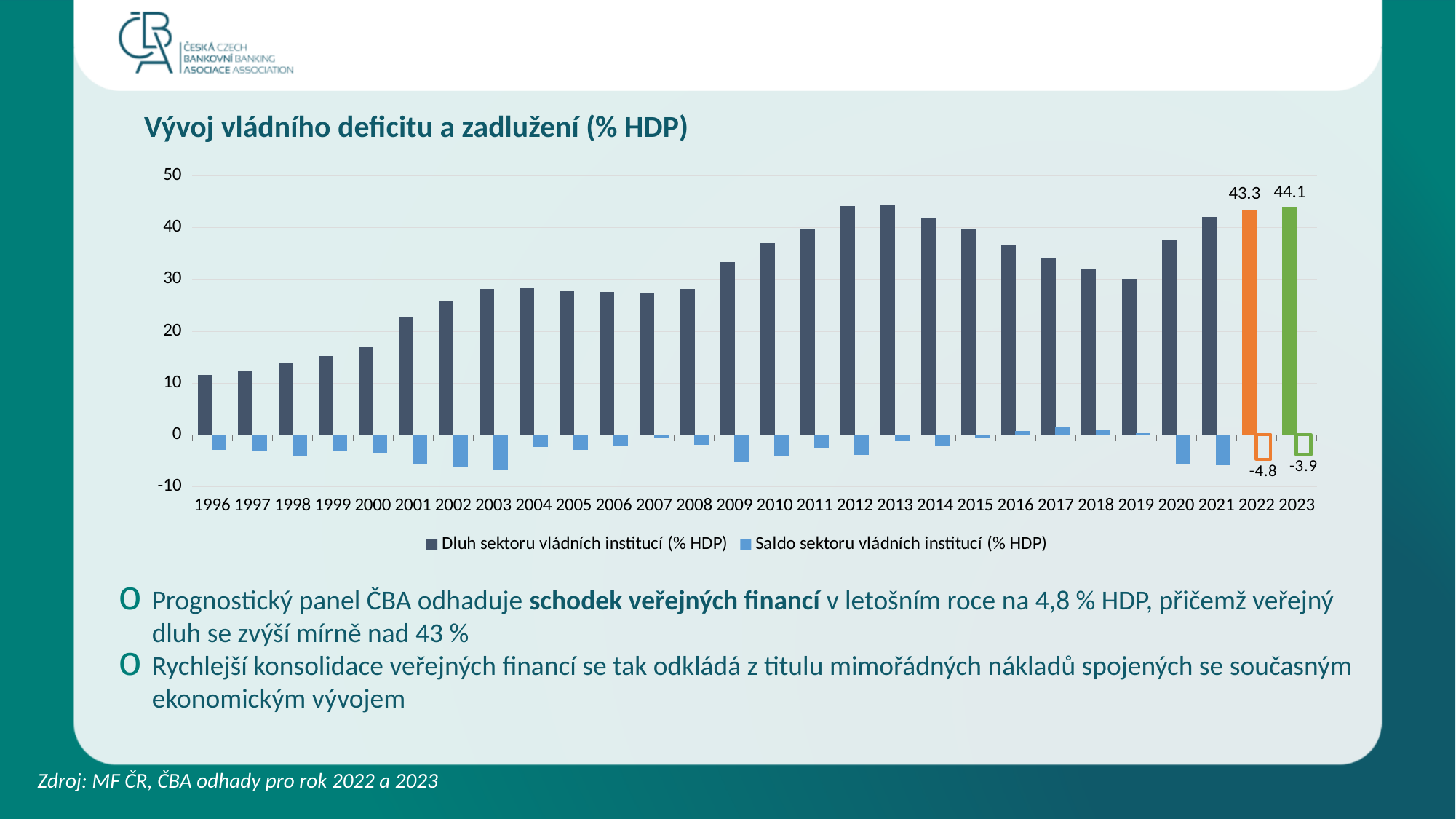
By how much does Dluh sektoru vládních institucí (% HDP) in 2023 exceed the value in 2022? 0.8 What kind of chart is shown on the slide? Bar chart What is the value of Saldo sektoru vládních institucí (% HDP) for 2022? -4.8 Which year has the larger Dluh sektoru vládních institucí (% HDP), 2022 or 2023? 2023 What is the value of Dluh sektoru vládních institucí (% HDP) for 2022? 43.3 How many series does the chart legend list? 2 Is the value of Dluh sektoru vládních institucí (% HDP) for 1998 greater or less than 20? less Which year has the lowest value of Dluh sektoru vládních institucí (% HDP)? 1996 What is the value of Saldo sektoru vládních institucí (% HDP) for 2023? -3.9 What is the value of Dluh sektoru vládních institucí (% HDP) for 2023? 44.1 Is the value of Dluh sektoru vládních institucí (% HDP) for 2009 greater or less than 30? greater How many years are shown on the x axis of the chart? 28